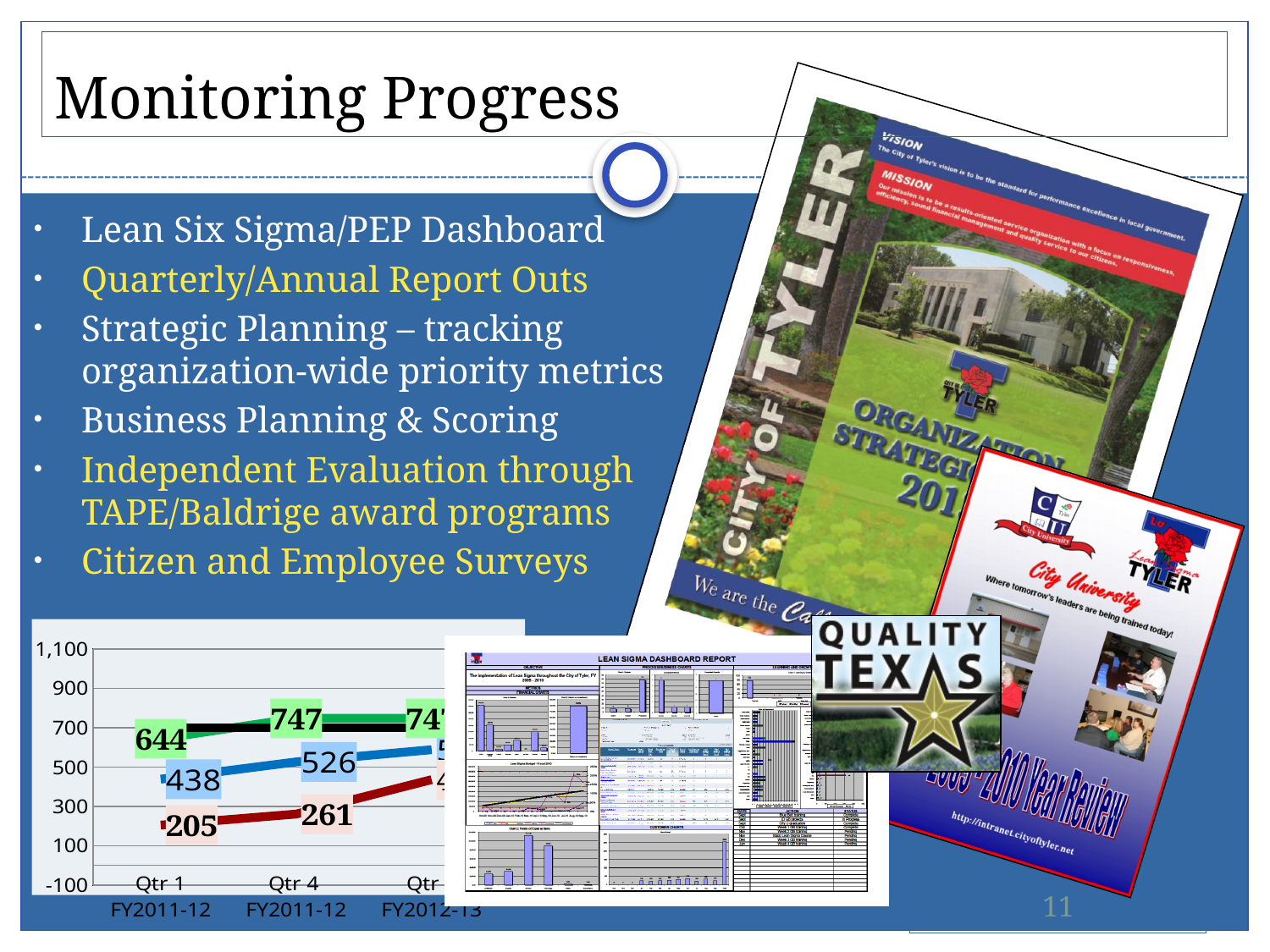
In the line chart at the bottom left, what is the value of the blue line at Qtr 4 FY2011-12? 526 In the line chart at the bottom left, what is the difference between the blue line's values at Qtr 4 FY2011-12 and Qtr 1 FY2011-12? 88 In the line chart at the bottom left, which line has the higher value at Qtr 4 FY2011-12, the blue line or the red line? the blue line In the line chart at the bottom left, is the red line's value at Qtr 1 FY2011-12 greater or less than 300? less In the line chart at the bottom left, what is the value of the top (green/black) line at Qtr 4 FY2011-12? 747 What kind of chart is shown at the bottom left of the slide? line chart In the line chart at the bottom left, what is the value of the red line at Qtr 4 FY2011-12? 261 In the line chart at the bottom left, does the blue line rise or fall from Qtr 1 FY2011-12 to Qtr 4 FY2011-12? rise In the line chart at the bottom left, what is the value of the red line at Qtr 1 FY2011-12? 205 In the line chart at the bottom left, what is the value of the blue line at Qtr 1 FY2011-12? 438